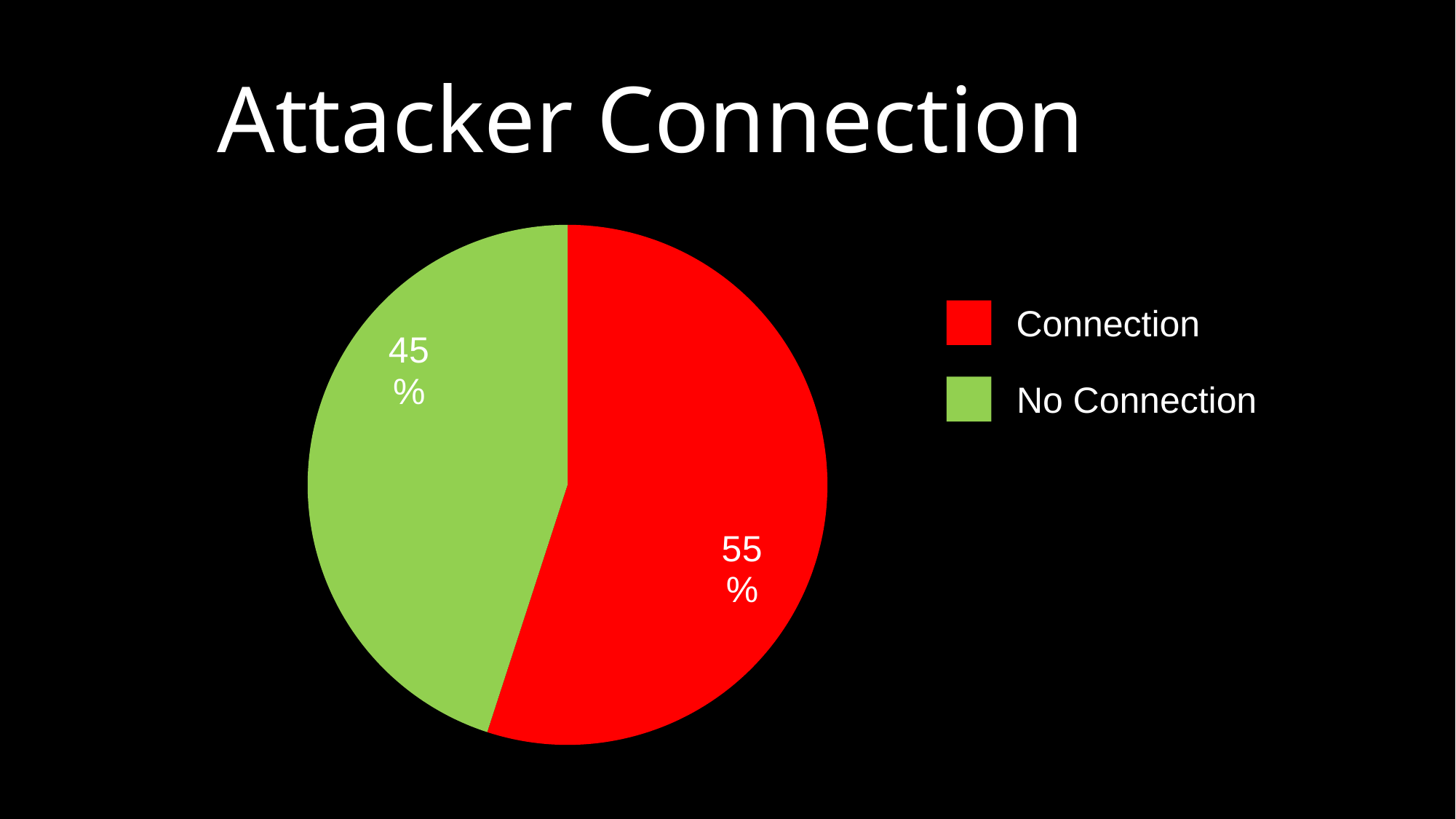
What is the difference between the Connection and No Connection shares? 10% Which slice is the smallest? No Connection What is the title of the chart? Attacker Connection What percentage of the pie is labelled for Connection? 55% What percentage of the pie is labelled for No Connection? 45% How many slices does the pie chart have? 2 What colour is the No Connection slice? green What share of the pie does the Connection slice represent? 55% What type of chart is shown on the slide? pie chart Which is larger, the Connection slice or the No Connection slice? Connection Which slice is the largest? Connection How many entries does the legend list? 2